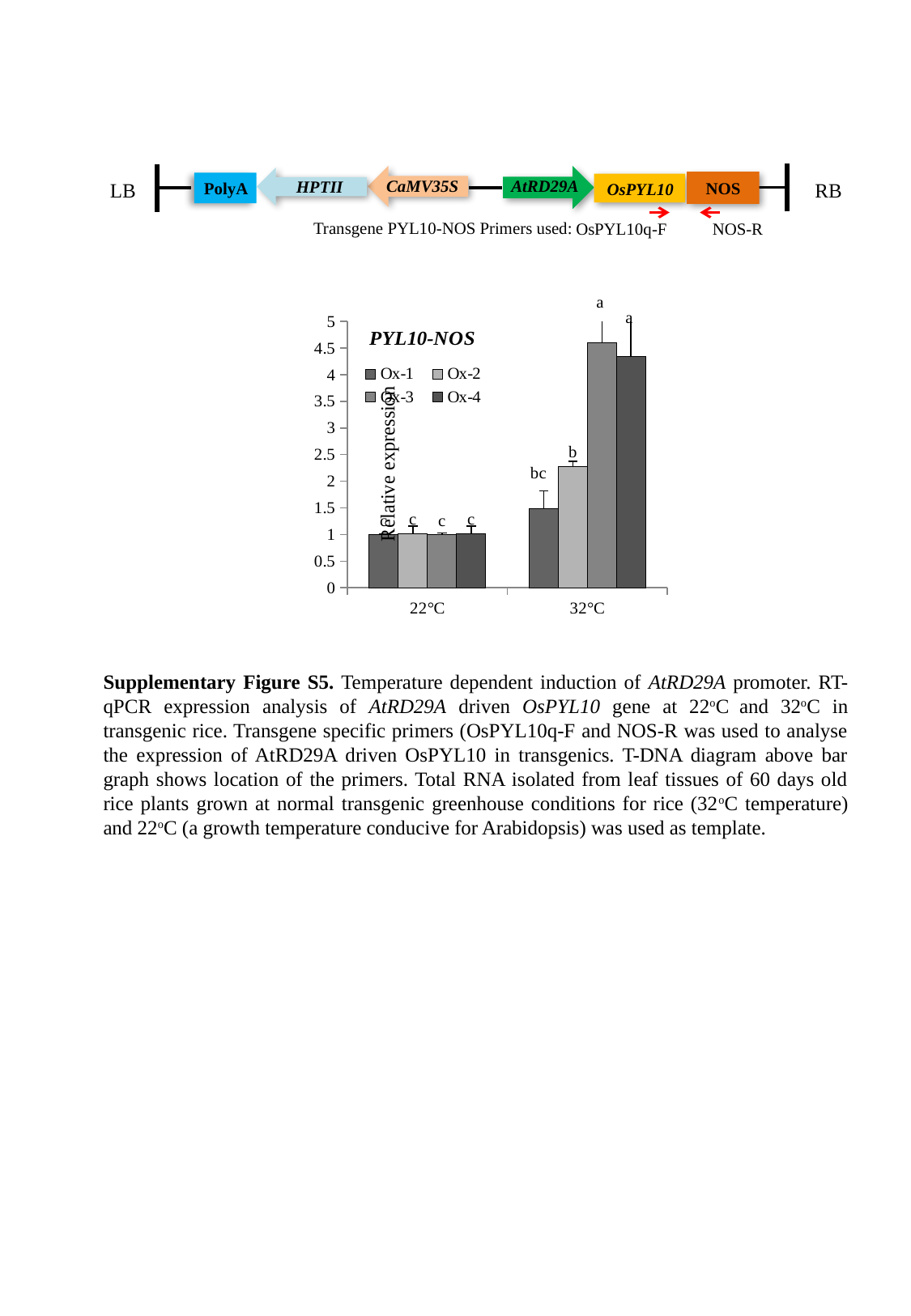
Is the value for Ox-3 at 32°C greater or less than 4? greater What is the title of the bar chart? PYL10-NOS How many temperature categories are shown on the x axis of the PYL10-NOS chart? 2 What kind of chart is shown on the slide? bar chart Is the value for Ox-4 at 32°C greater or less than 4? greater How many series does the legend of the PYL10-NOS chart list? 4 Which series has the highest value at 32°C? Ox-3 Is the value for Ox-1 at 32°C greater or less than 2? less Which series has the lowest value at 32°C? Ox-1 At 32°C, which is larger, the value for Ox-1 or the value for Ox-2? Ox-2 What is the label of the y axis of the bar chart? Relative expression